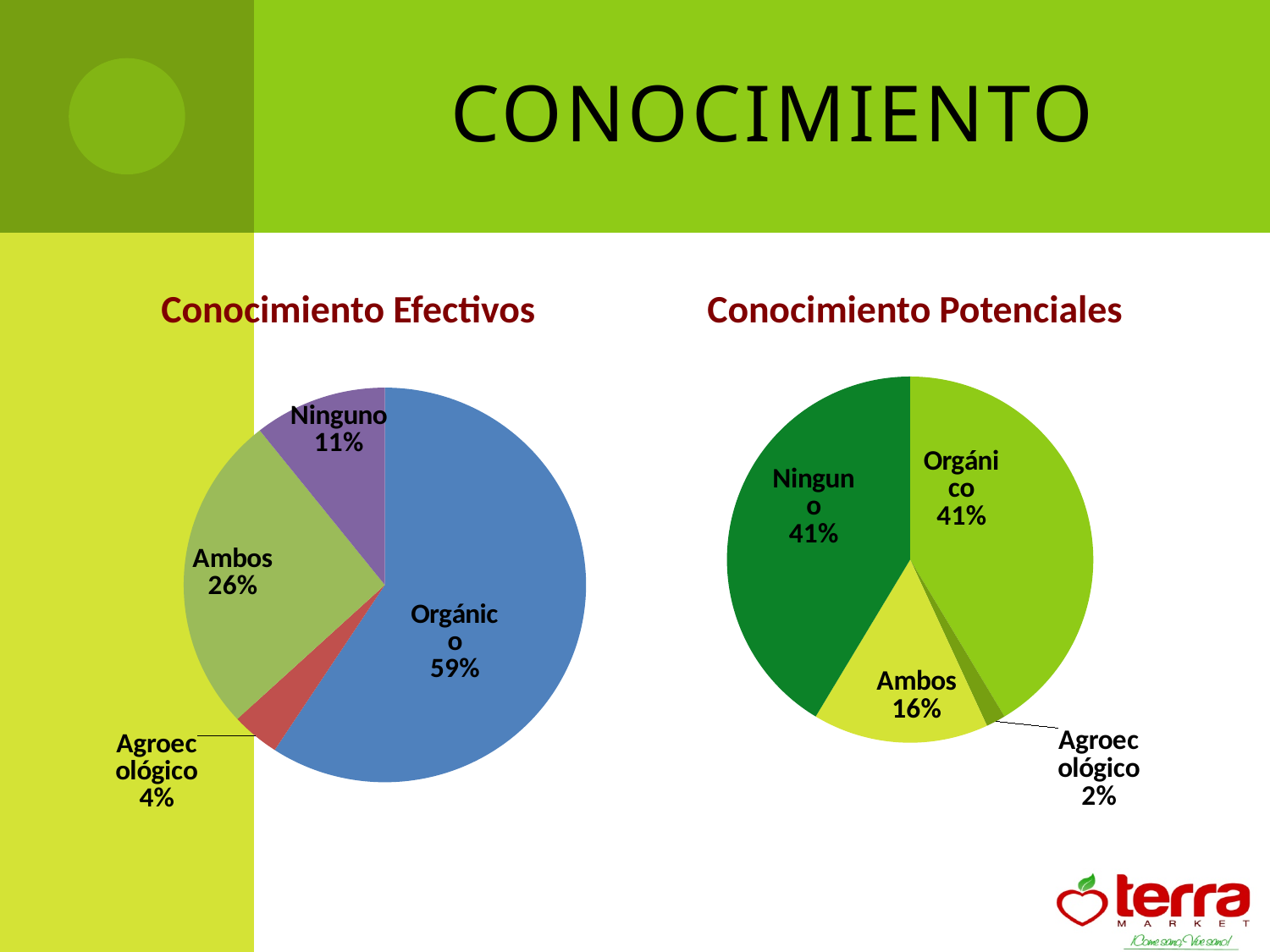
How many categories does the 'Conocimiento Potenciales' chart show? 4 In the 'Conocimiento Efectivos' chart, which category has the smallest share? Agroecológico What kind of chart is 'Conocimiento Efectivos'? Pie chart In the 'Conocimiento Potenciales' chart, which category has the smallest share? Agroecológico In the 'Conocimiento Potenciales' chart, what is the difference between the Ninguno and Ambos shares? 25% In the 'Conocimiento Potenciales' chart, what share does Agroecológico have? 2% In the 'Conocimiento Efectivos' chart, what share does Orgánico have? 59% In the 'Conocimiento Efectivos' chart, which category has the largest share? Orgánico In the 'Conocimiento Efectivos' chart, what share does Ambos have? 26% In the 'Conocimiento Efectivos' chart, what is the difference between the Orgánico and Ambos shares? 33% In the 'Conocimiento Potenciales' chart, what share does Ambos have? 16% In the 'Conocimiento Efectivos' chart, which is larger, Ninguno or Ambos? Ambos